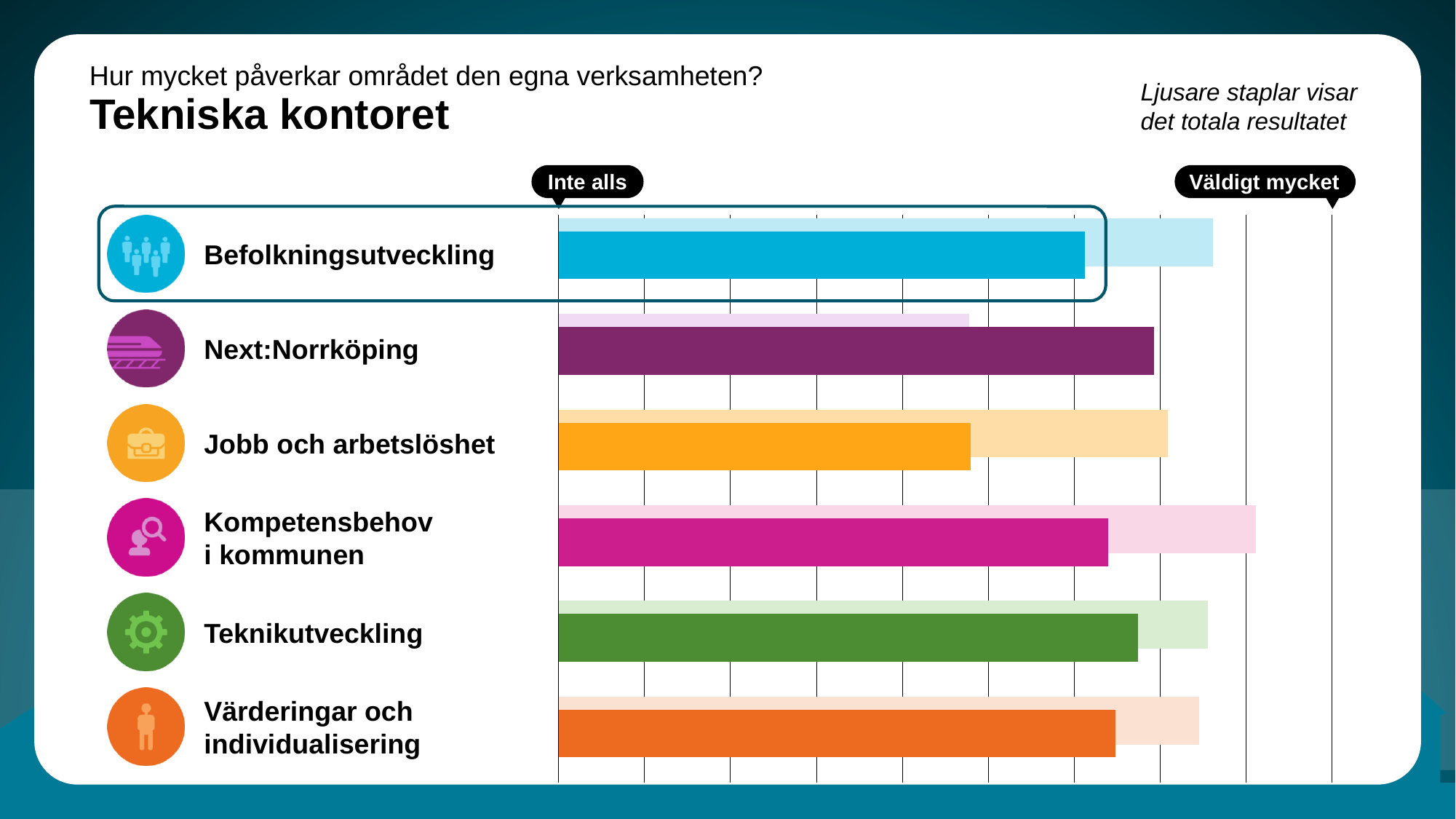
What kind of chart is shown on the slide? Bar chart Which dark bar is longer: Next:Norrköping or Jobb och arbetslöshet? Next:Norrköping According to the note on the slide, what do the lighter bars show? Det totala resultatet For Next:Norrköping, which bar is longer: the dark bar or the light bar? The dark bar How many bars are shown for each category in the chart? 2 Which category has the longest light bar (highest total result)? Kompetensbehov i kommunen Which category has the shortest dark bar (lowest value for Tekniska kontoret)? Jobb och arbetslöshet How many categories (areas) are plotted in the chart? 6 Which category has the shortest light bar (lowest total result)? Next:Norrköping Which dark bar is longer: Befolkningsutveckling or Jobb och arbetslöshet? Befolkningsutveckling What is the title of the chart on the slide? Tekniska kontoret